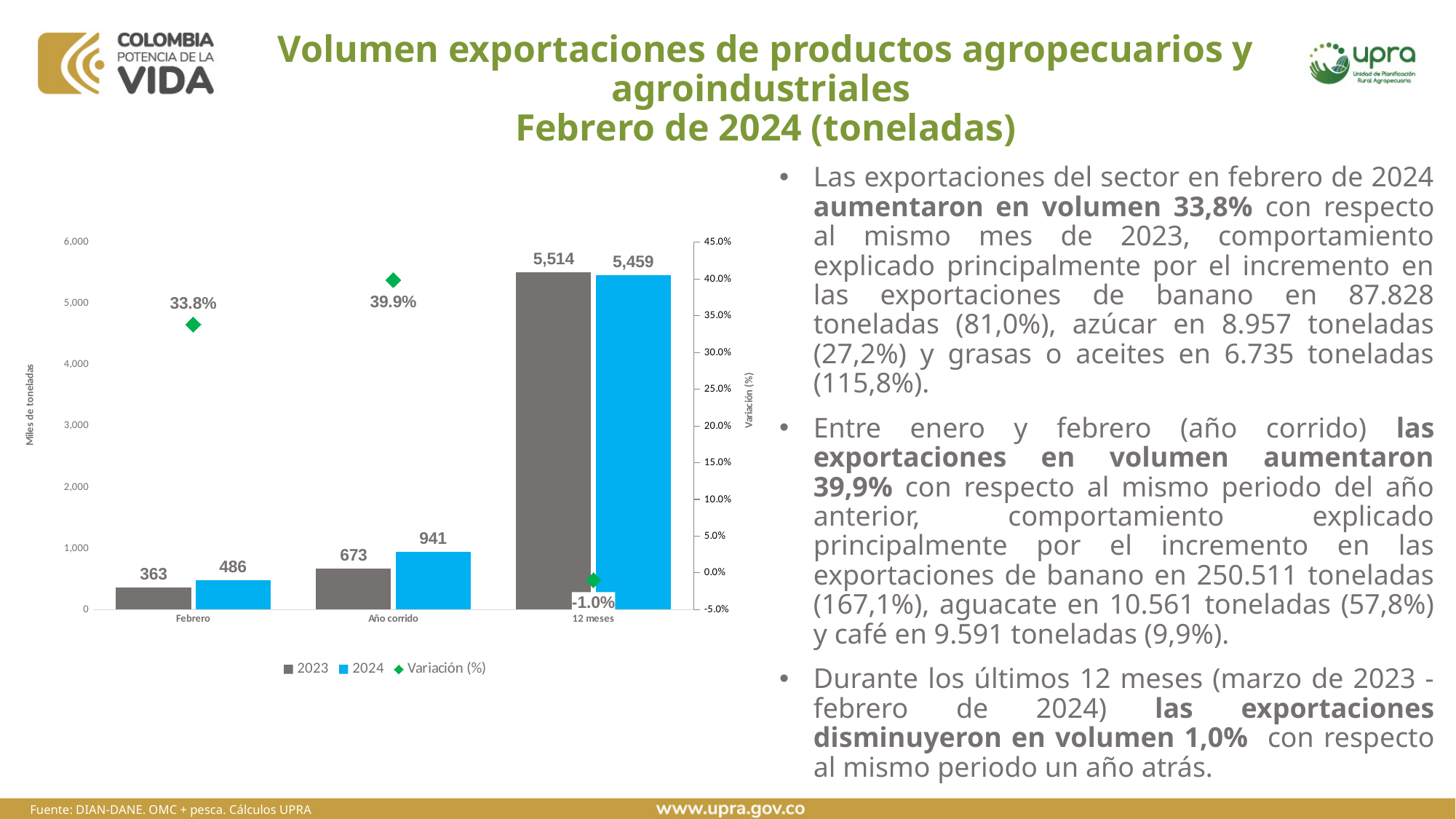
How many categories are shown on the x axis? 3 How many series does the legend list? 3 What is the 2023 value for 12 meses? 5,514 Which category has the lowest 2023 value? Febrero What kind of chart is shown on the slide? Combination chart: bars for 2023 and 2024 with diamond markers for Variación (%) What is the 2023 value for Año corrido? 673 For 12 meses, which is larger: the 2023 value or the 2024 value? 2023 Which category has the highest 2024 value? 12 meses What is the 2024 value for Febrero? 486 What is the Variación (%) value for Año corrido? 39.9% What is the difference between the 2024 and 2023 values for Año corrido? 268 What is the Variación (%) value for 12 meses? -1.0%